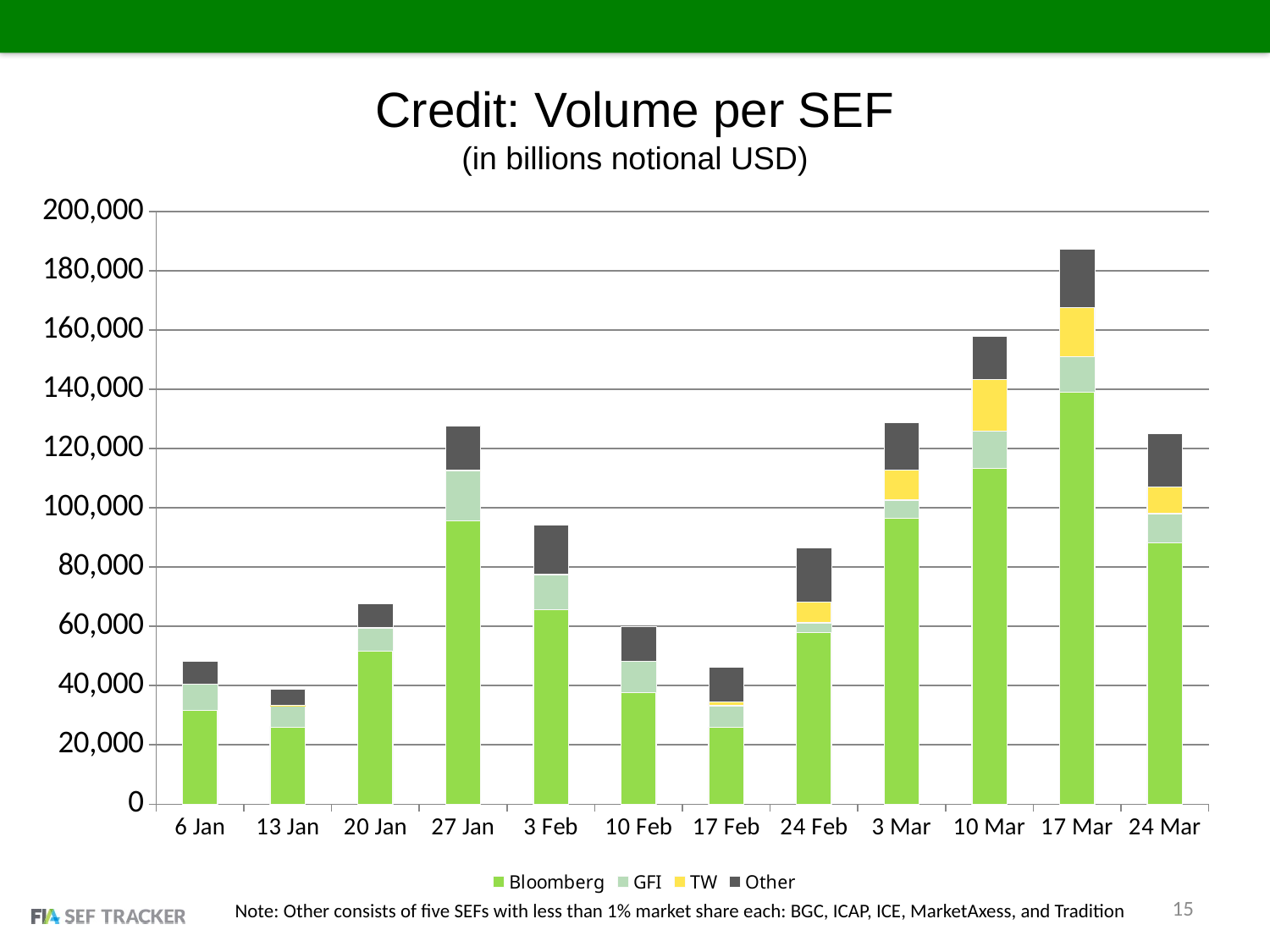
Is the total volume for 27 Jan greater or less than 120,000? greater What kind of chart is shown on the slide? Stacked bar chart Which has the larger total volume, 10 Mar or 24 Feb? 10 Mar Which date has the lowest total volume? 13 Jan How many weekly dates are shown on the x axis? 12 Is the Bloomberg volume for 17 Mar greater or less than 120,000? greater Which date has the highest total volume? 17 Mar Is the total volume for 17 Mar greater or less than 180,000? greater Which has the larger total volume, 27 Jan or 3 Feb? 27 Jan How many series does the legend list? 4 Which series is shown in yellow in the legend? TW